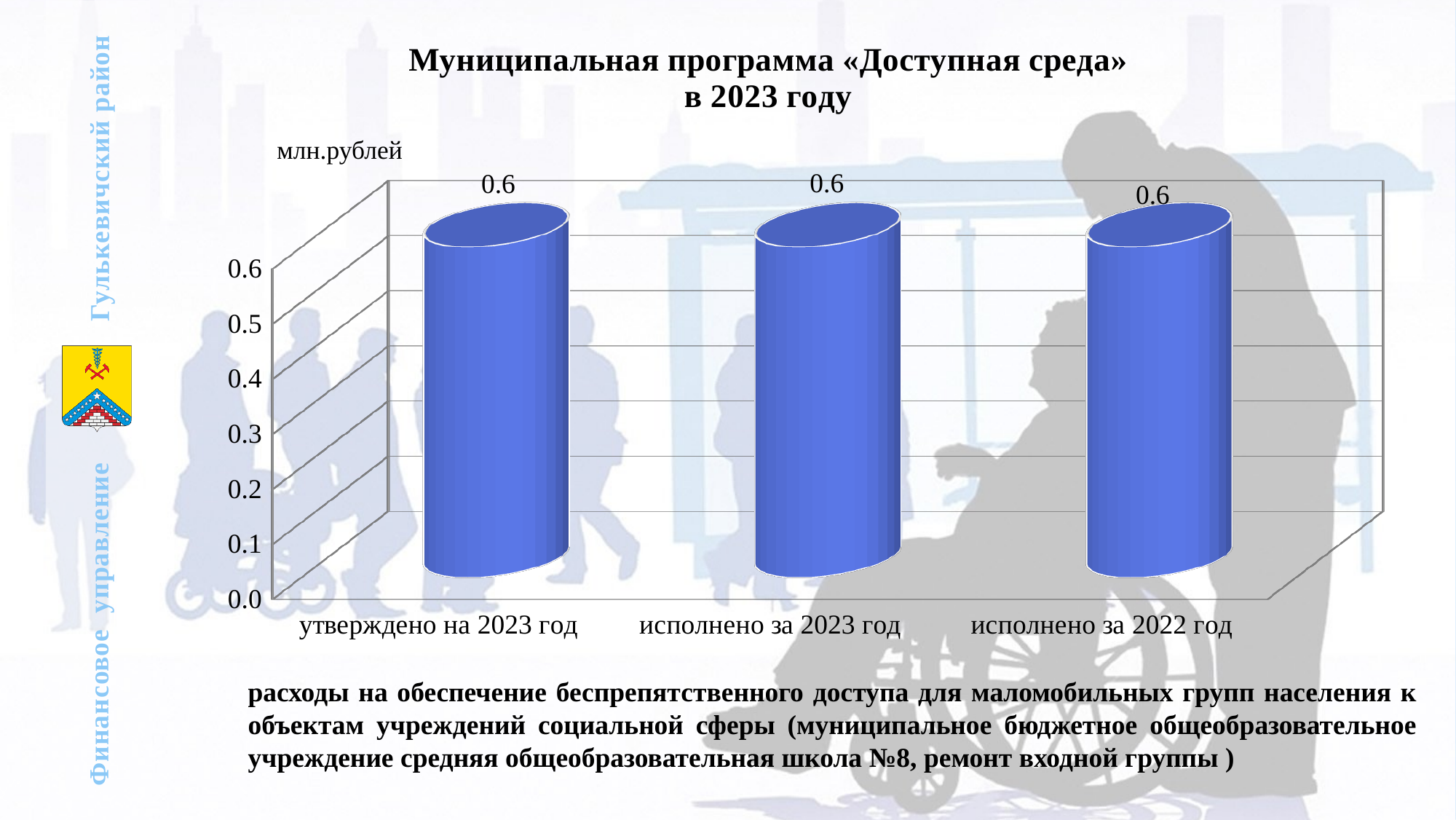
What is the value for «исполнено за 2022 год»? 0.6 In what units are the values on the chart expressed? млн.рублей Do the values rise, fall, or stay the same across the categories from left to right? stay the same What is the title of the chart? Муниципальная программа «Доступная среда» в 2023 году Is the value for «утверждено на 2023 год» greater or less than 0.5? greater What is the value for «утверждено на 2023 год»? 0.6 What kind of chart is shown on the slide? bar chart What is the difference between the value for «утверждено на 2023 год» and the value for «исполнено за 2023 год»? 0 What is the value for «исполнено за 2023 год»? 0.6 Is the value for «исполнено за 2022 год» larger than, smaller than, or equal to the value for «исполнено за 2023 год»? equal How many bars are plotted in the chart? 3